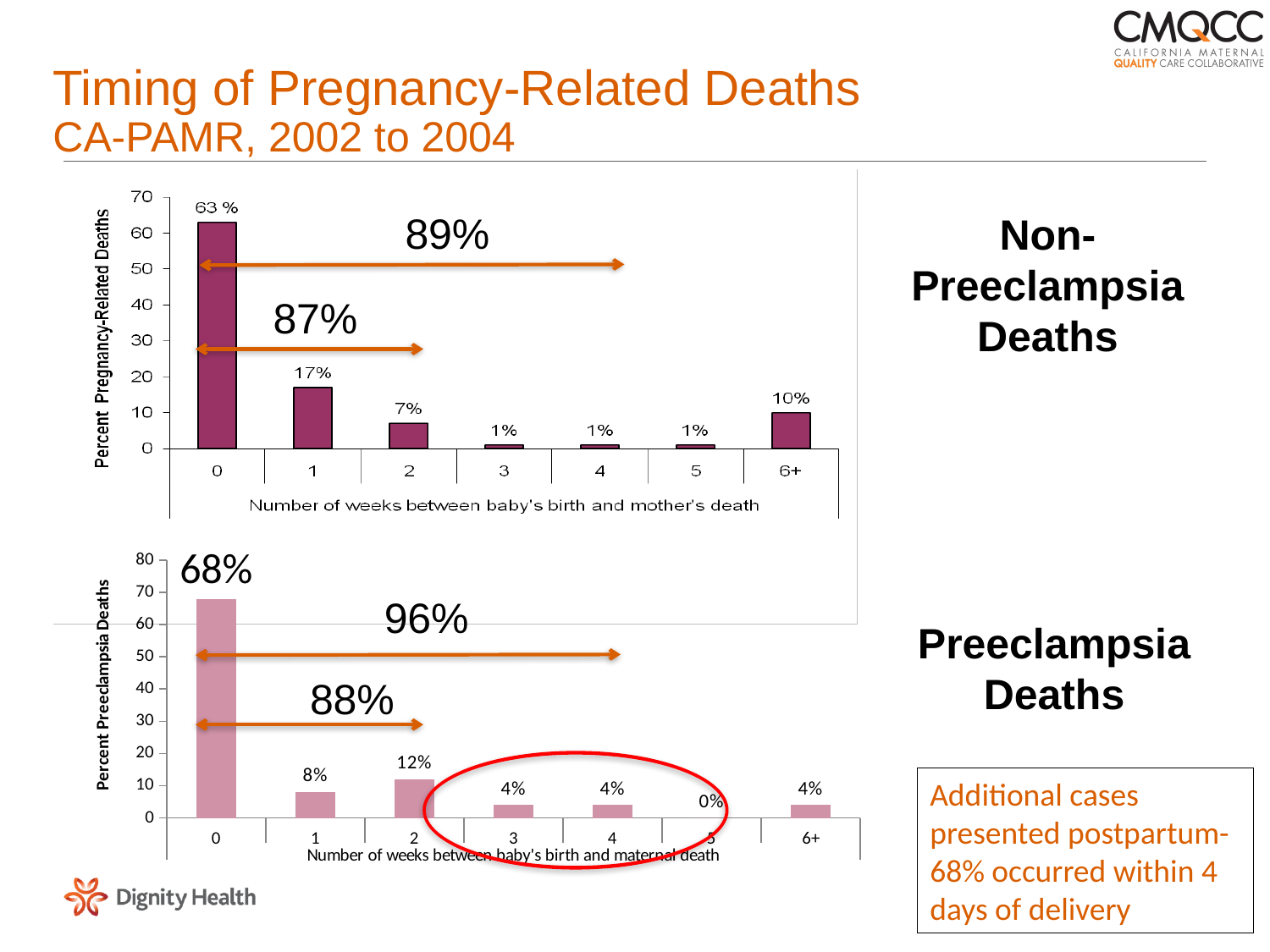
In the Non-Preeclampsia Deaths chart, which number of weeks has the highest percentage? 0 In the Non-Preeclampsia Deaths chart, what is the value for 6+ weeks? 10% In the Non-Preeclampsia Deaths chart, what percentage of pregnancy-related deaths occurred at 0 weeks between the baby's birth and the mother's death? 63 % In the Preeclampsia Deaths chart, what is the difference between the values for 0 weeks and 1 week? 60% In the Preeclampsia Deaths chart, which number of weeks has the lowest percentage? 5 In the Preeclampsia Deaths chart, which is larger, the value for 1 week or the value for 2 weeks? 2 weeks In the Preeclampsia Deaths chart, what is the value for 5 weeks? 0% What is the x-axis label of the Non-Preeclampsia Deaths chart? Number of weeks between baby's birth and mother's death In the Non-Preeclampsia Deaths chart, what is the difference between the values for 1 week and 2 weeks? 10% What type of chart is the Preeclampsia Deaths chart? Bar chart How many week categories are shown on the x axis of the Non-Preeclampsia Deaths chart? 7 In the Preeclampsia Deaths chart, what is the value for 2 weeks? 12%